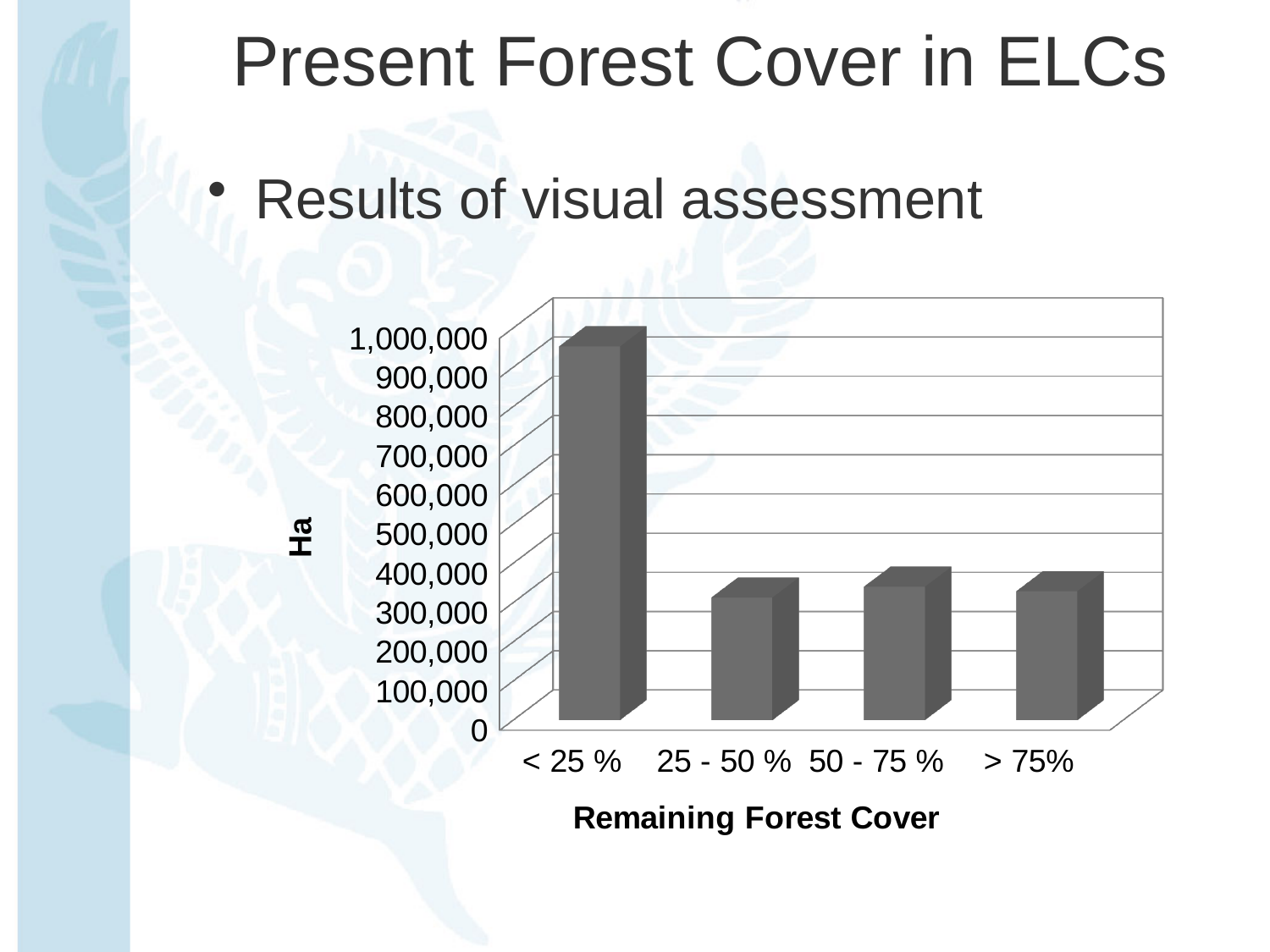
Is the value for > 75% greater or less than 400,000? less Is the value for < 25 % greater or less than 800,000? greater What is the title of the horizontal axis of the chart? Remaining Forest Cover Is the value for 50 - 75 % greater or less than 500,000? less Which remaining forest cover category has the highest value in the chart? < 25 % Does the value rise or fall from < 25 % to 25 - 50 %? fall What kind of chart is shown on the slide? bar chart What is the title of the vertical axis of the chart? Ha Which is larger, the value for < 25 % or the value for > 75%? < 25 % How many categories are shown on the x axis of the chart? 4